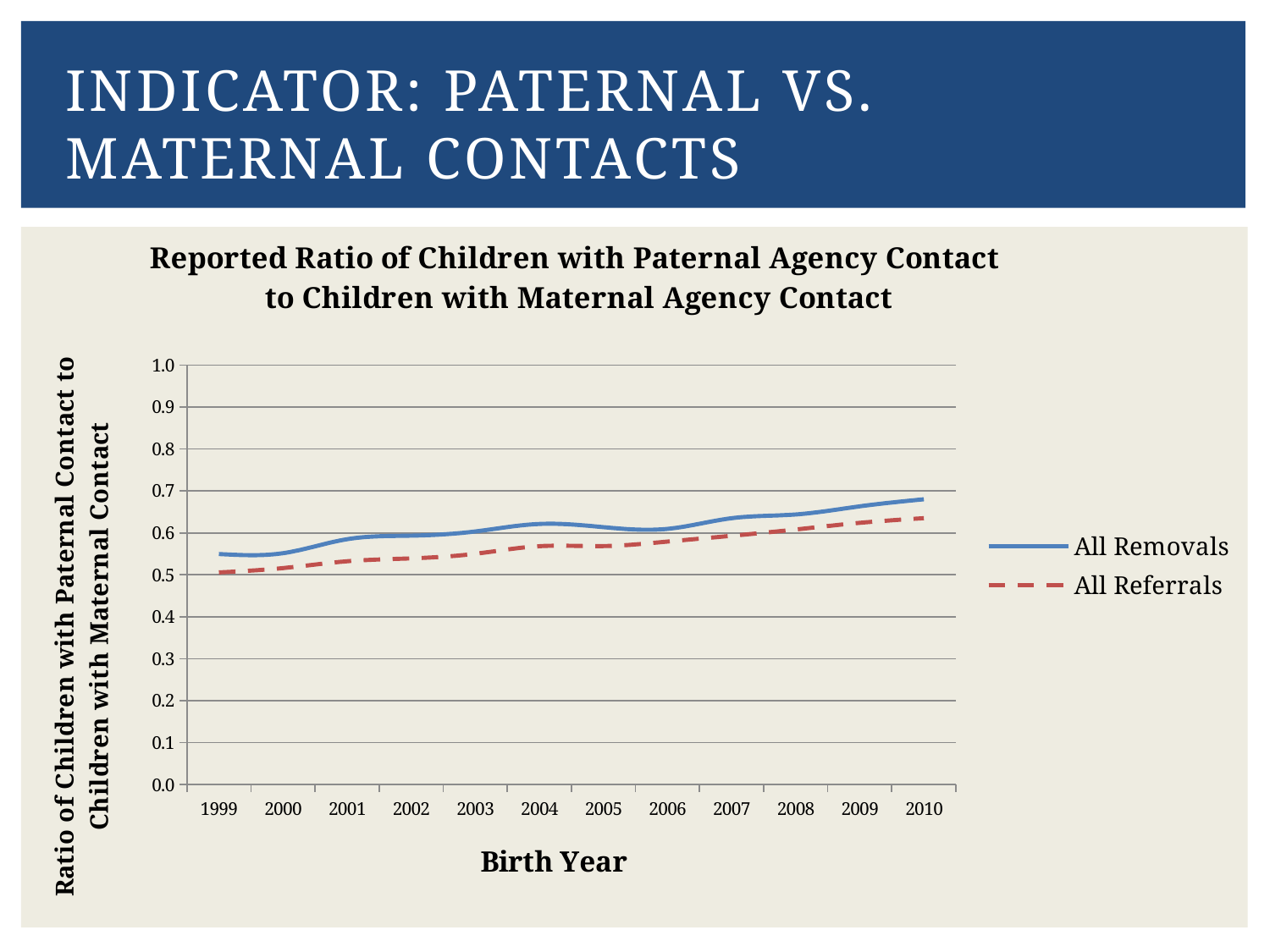
Is the All Removals value for 2010 greater or less than 0.6? greater Does the All Referrals line rise or fall from 1999 to 2010? Rises In which birth year is the All Referrals ratio lowest? 1999 Does the All Removals line rise or fall from 1999 to 2010? Rises What kind of chart is shown on the slide? Line chart What is the label of the x axis? Birth Year How many series does the legend list? 2 Is the All Removals value for 1999 greater or less than 0.6? less Is the All Referrals value for 1999 greater or less than 0.6? less How many birth years are plotted along the x axis? 12 In which birth year is the All Removals ratio highest? 2010 For birth year 2010, which series has the higher ratio, All Removals or All Referrals? All Removals